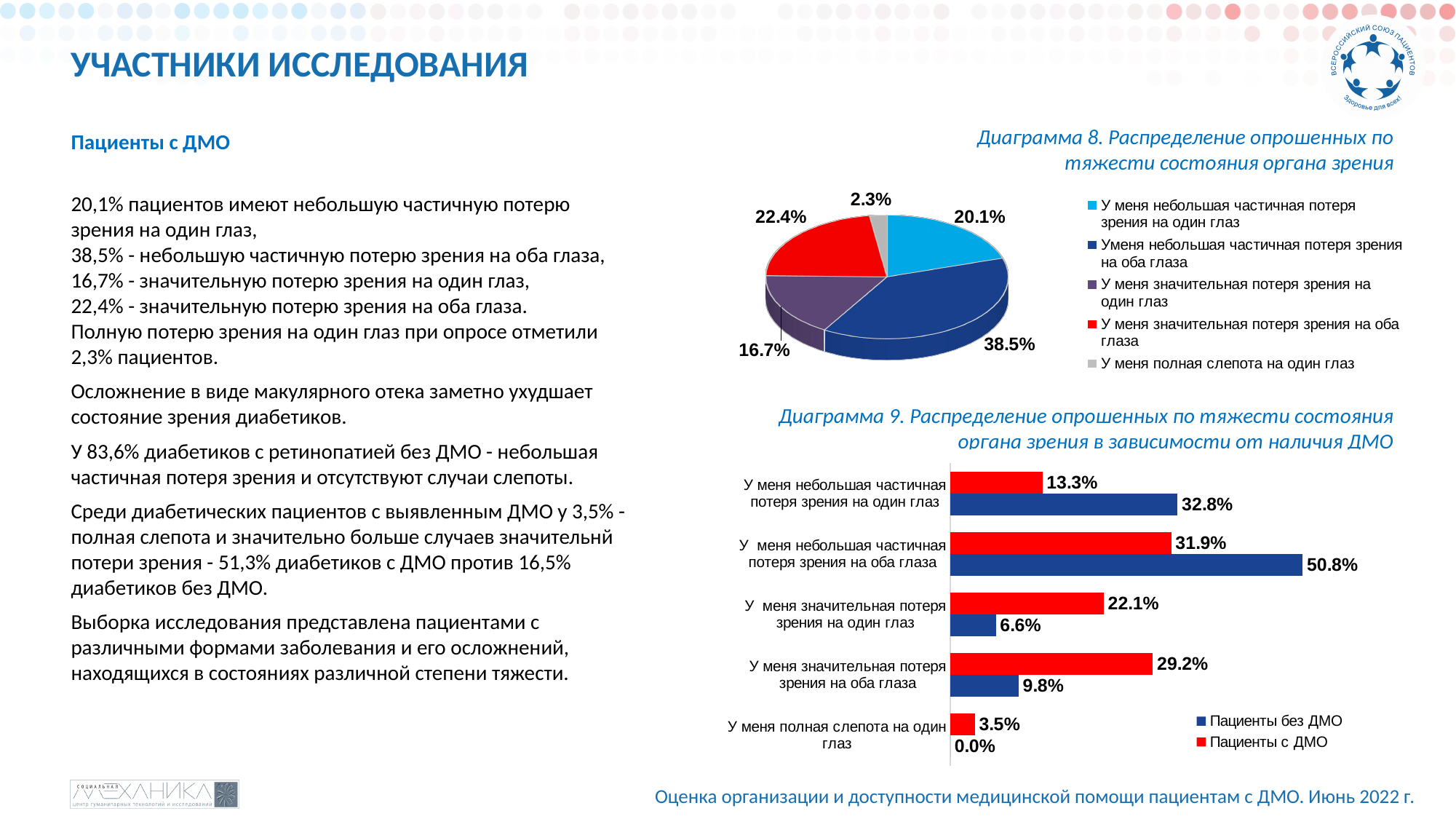
In Диаграмма 9, what is the difference between Пациенты с ДМО and Пациенты без ДМО for 'У меня значительная потеря зрения на оба глаза'? 19.4% What kind of chart is Диаграмма 8? Pie chart In Диаграмма 9, what is the value for Пациенты с ДМО in the category 'У меня полная слепота на один глаз'? 3.5% In Диаграмма 9, how many categories are shown? 5 In Диаграмма 8, which category has the largest slice? Уменя небольшая частичная потеря зрения на оба глаза In Диаграмма 9, how many series does the legend list? 2 What kind of chart is Диаграмма 9? Bar chart In Диаграмма 8, which category has the smallest slice? У меня полная слепота на один глаз In Диаграмма 8, what share of respondents reported a small partial loss of vision in both eyes (Уменя небольшая частичная потеря зрения на оба глаза)? 38.5% In Диаграмма 9, which series has the larger value for 'У меня небольшая частичная потеря зрения на один глаз'? Пациенты без ДМО In Диаграмма 8, how many entries does the legend list? 5 In Диаграмма 9, what is the value for Пациенты без ДМО in the category 'У меня небольшая частичная потеря зрения на оба глаза'? 50.8%